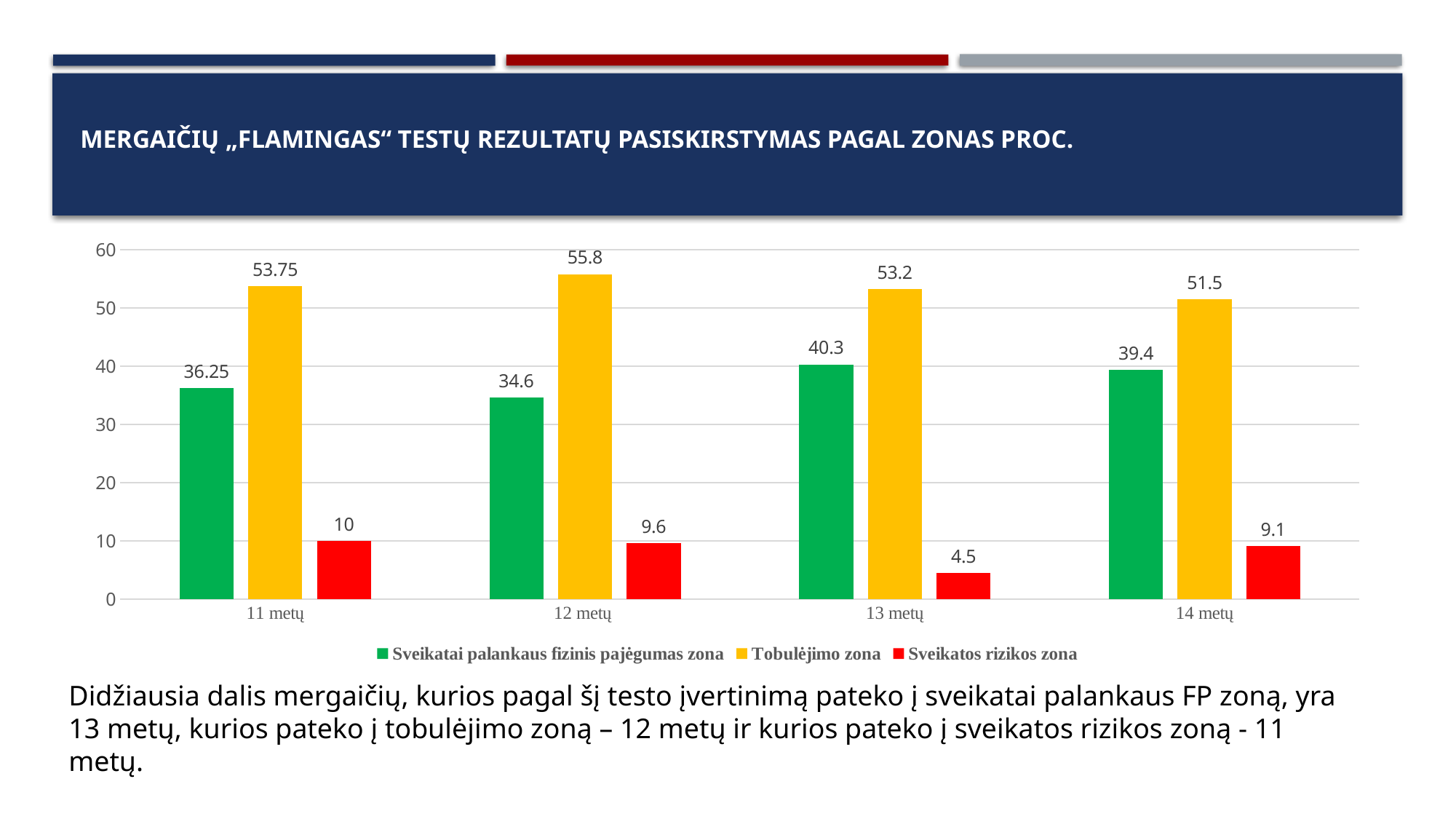
How many age groups are shown on the x axis? 4 What is the value for Sveikatai palankaus fizinis pajėgumas zona at 11 metų? 36.25 What is the value for Tobulėjimo zona at 12 metų? 55.8 What kind of chart is shown on the slide? Bar chart Which is larger at 12 metų: Sveikatai palankaus fizinis pajėgumas zona or Tobulėjimo zona? Tobulėjimo zona Which age group has the highest value for Sveikatai palankaus fizinis pajėgumas zona? 13 metų What is the difference between the Tobulėjimo zona value and the Sveikatai palankaus fizinis pajėgumas zona value at 14 metų? 12.1 How many series does the legend list? 3 What colour represents Sveikatos rizikos zona in the chart? Red Which age group has the highest value for Tobulėjimo zona? 12 metų Which age group has the lowest value for Sveikatos rizikos zona? 13 metų What is the value for Sveikatos rizikos zona at 13 metų? 4.5